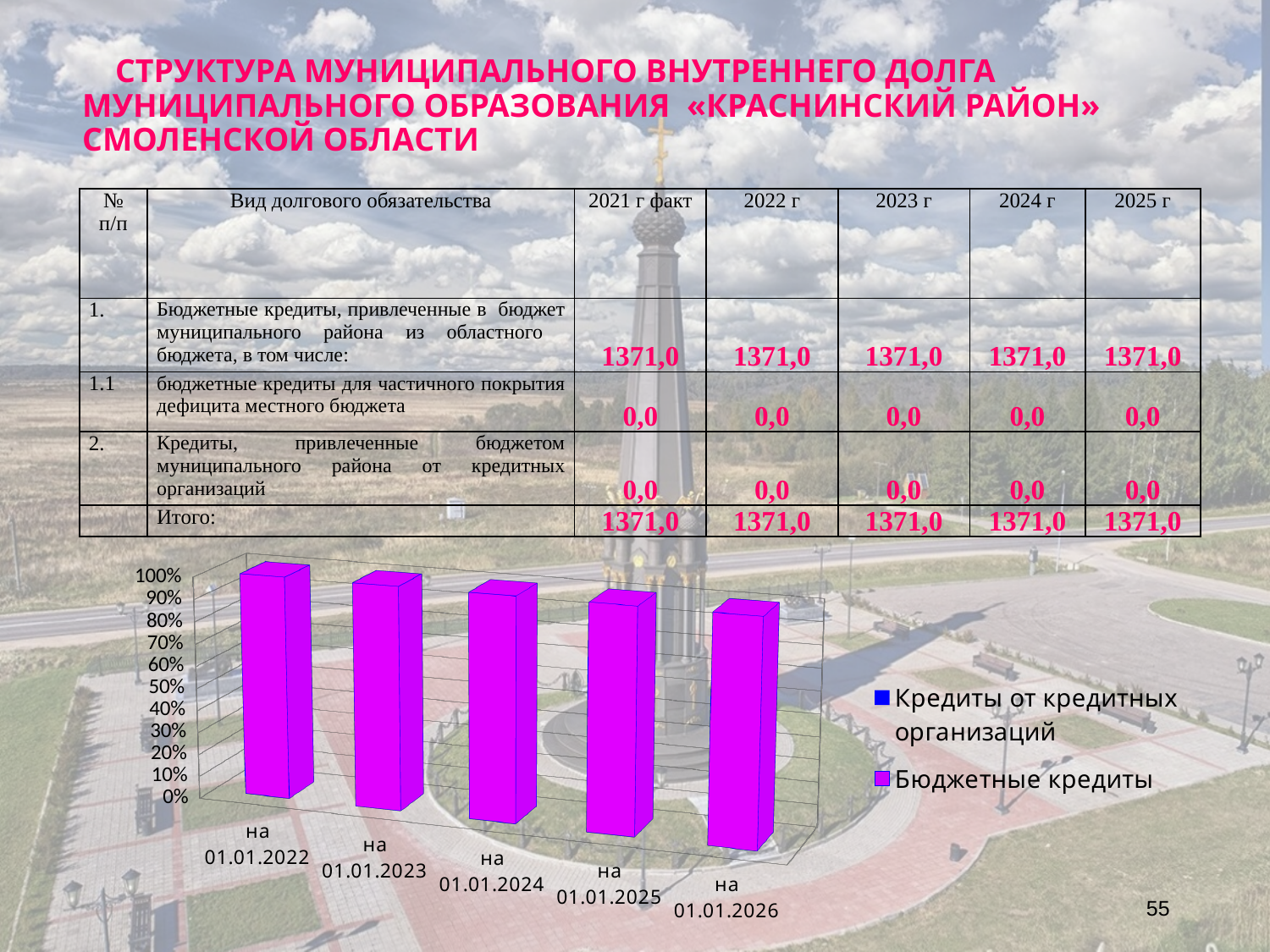
How many series does the chart legend list? 2 How many categories (dates) are shown on the x axis of the chart? 5 What is the label of the first category on the x axis of the chart? на 01.01.2022 What kind of chart is shown on the slide? bar chart Is the value for Бюджетные кредиты on 01.01.2026 greater or less than 50%? greater Is the value for Бюджетные кредиты on 01.01.2022 greater or less than 50%? greater What is the label of the last category on the x axis of the chart? на 01.01.2026 What are the two series listed in the chart legend? Кредиты от кредитных организаций; Бюджетные кредиты Which series is shown in magenta in the chart? Бюджетные кредиты Is the value for Бюджетные кредиты on 01.01.2024 greater or less than 50%? greater What is the highest value shown on the chart's vertical axis? 100%